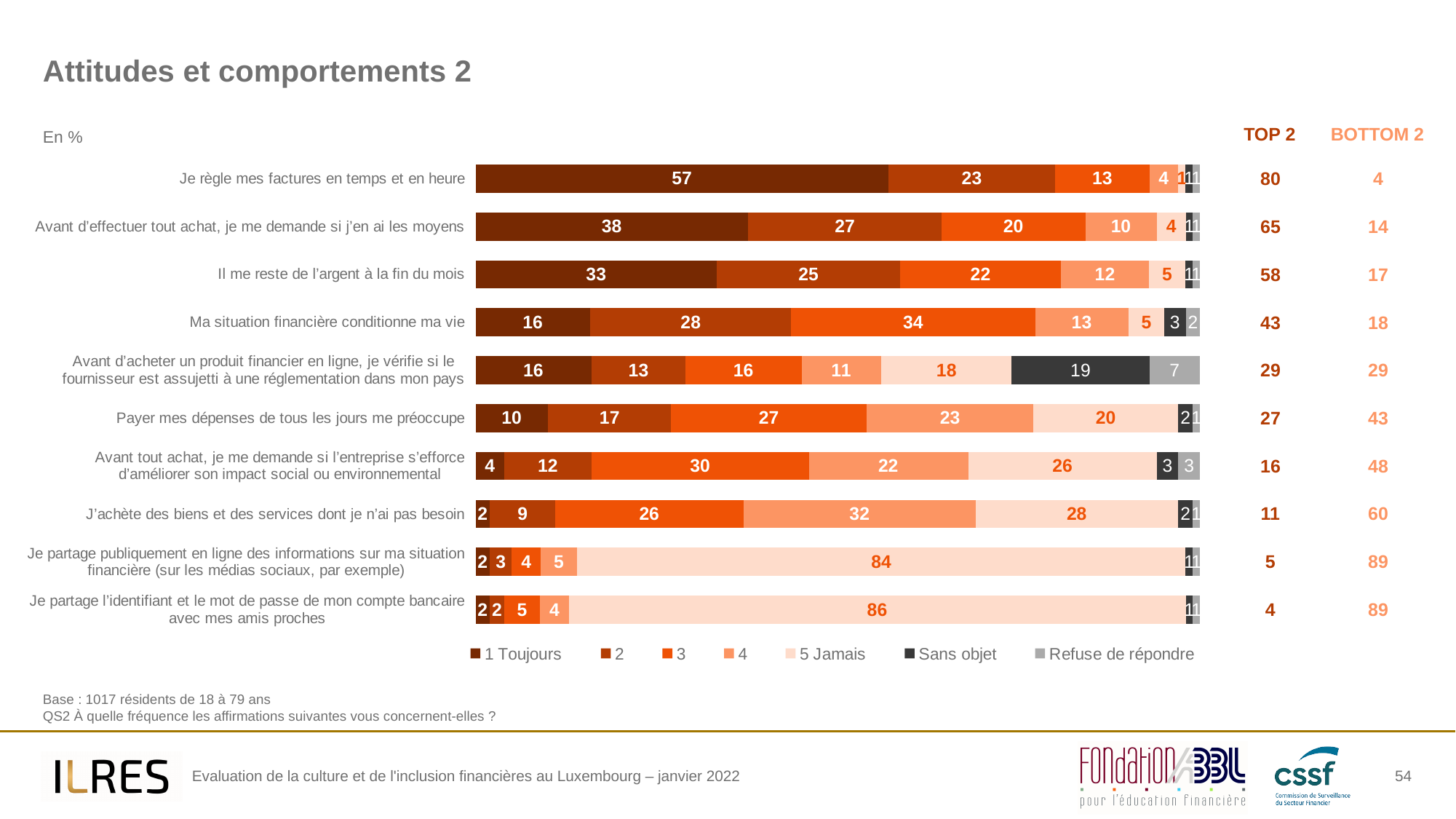
What is the TOP 2 value shown for 'Il me reste de l'argent à la fin du mois'? 58 How many statements (categories) are plotted in the chart? 10 What is the value of '1 Toujours' for 'Je règle mes factures en temps et en heure'? 57 Which is larger: the '3' value for 'Ma situation financière conditionne ma vie' or the '3' value for 'Payer mes dépenses de tous les jours me préoccupe'? Ma situation financière conditionne ma vie Which statement has the highest '5 Jamais' value? Je partage l'identifiant et le mot de passe de mon compte bancaire avec mes amis proches What kind of chart is shown on the slide? Stacked bar chart Which statement has the highest '1 Toujours' value? Je règle mes factures en temps et en heure What is the BOTTOM 2 value shown for 'J'achète des biens et des services dont je n'ai pas besoin'? 60 What is the value of '5 Jamais' for 'Je partage l'identifiant et le mot de passe de mon compte bancaire avec mes amis proches'? 86 How many series does the legend list? 7 What is the 'Sans objet' value for 'Avant d'acheter un produit financier en ligne, je vérifie si le fournisseur est assujetti à une réglementation dans mon pays'? 19 What is the difference between the '1 Toujours' values for 'Je règle mes factures en temps et en heure' and 'Avant d'effectuer tout achat, je me demande si j'en ai les moyens'? 19